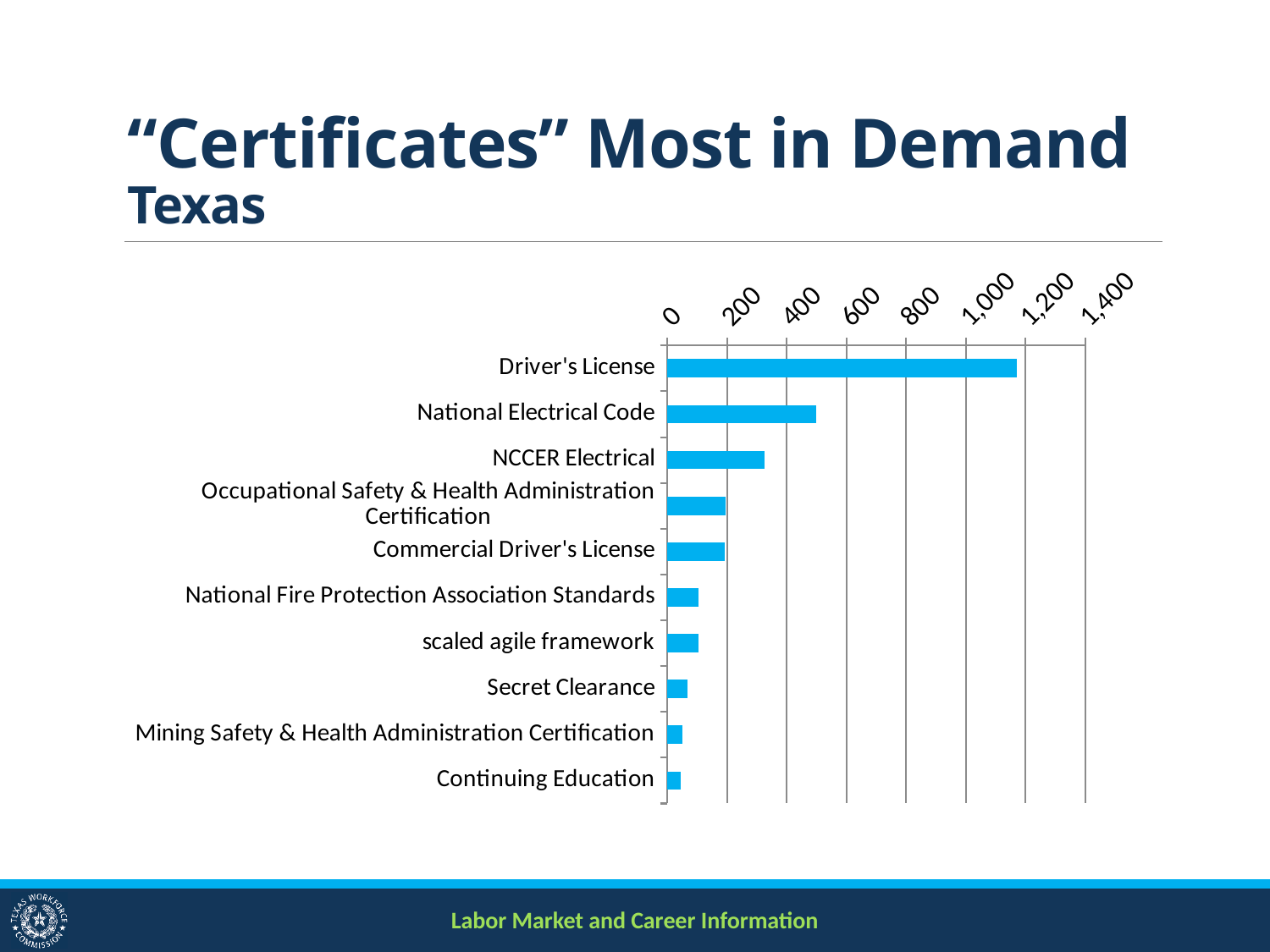
Is the value for National Electrical Code greater or less than 400? greater Is the value for NCCER Electrical greater or less than 400? less What kind of chart is shown on the slide? Bar chart Is the value for Secret Clearance greater or less than 200? less Which certificate has the highest value on the chart? Driver's License Which is larger, the value for Driver's License or the value for National Electrical Code? Driver's License What is the title of the slide? "Certificates" Most in Demand Texas Which is larger, the value for NCCER Electrical or the value for Commercial Driver's License? NCCER Electrical How many certificate categories are shown on the chart? 10